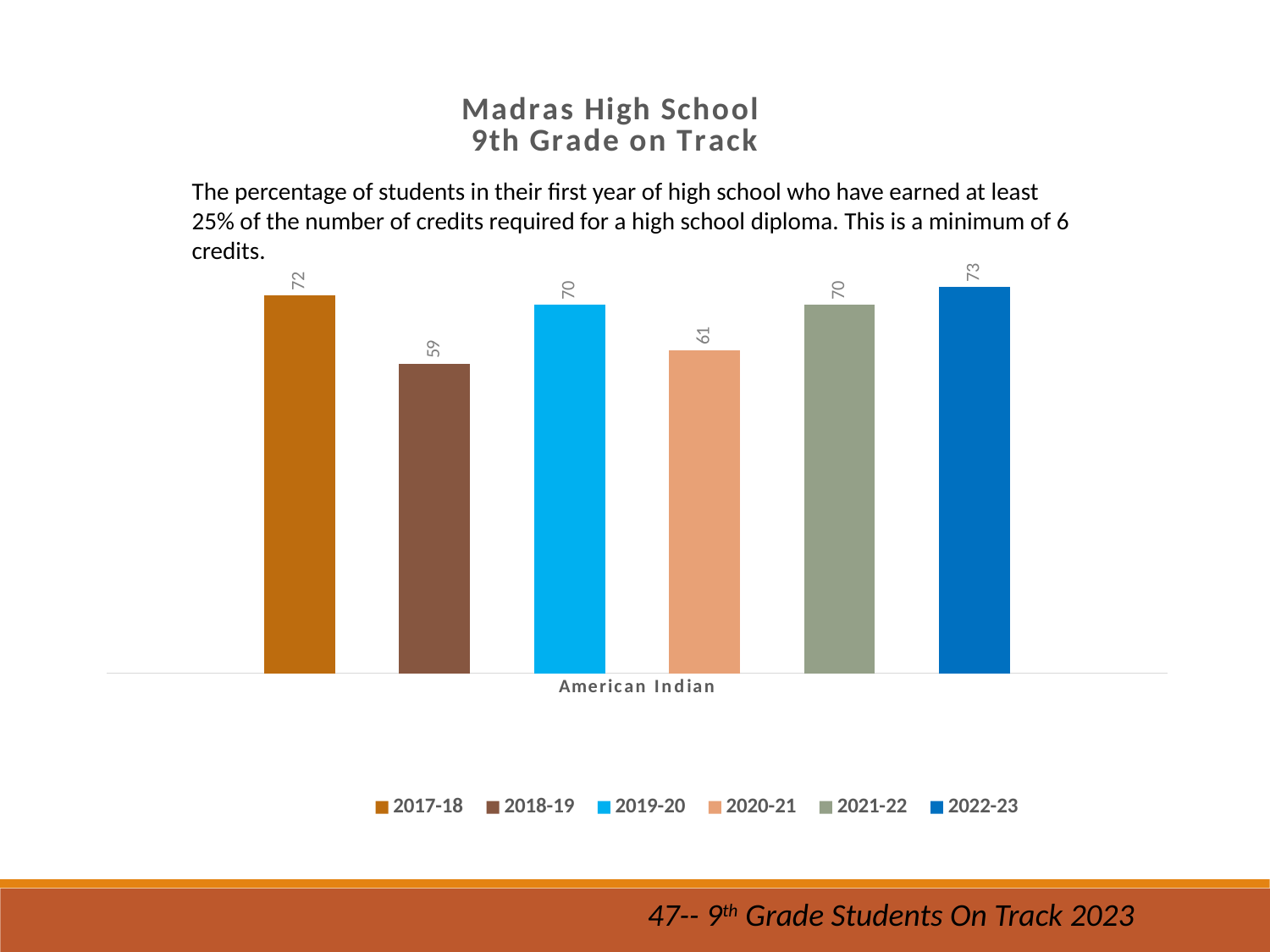
What is the value for 2017-18 for American Indian students? 72 How many series does the legend list? 6 What is the value for 2020-21 for American Indian students? 61 What is the value for 2022-23 for American Indian students? 73 What is the difference between the 2017-18 value and the 2020-21 value? 11 What is the value for 2018-19 for American Indian students? 59 What is the difference between the 2022-23 value and the 2018-19 value? 14 What kind of chart is shown on the slide? Bar chart Which is larger, the value for 2019-20 or the value for 2020-21? 2019-20 Which school year has the lowest value for American Indian students? 2018-19 What is the category label shown on the x axis? American Indian Which school year has the highest value for American Indian students? 2022-23